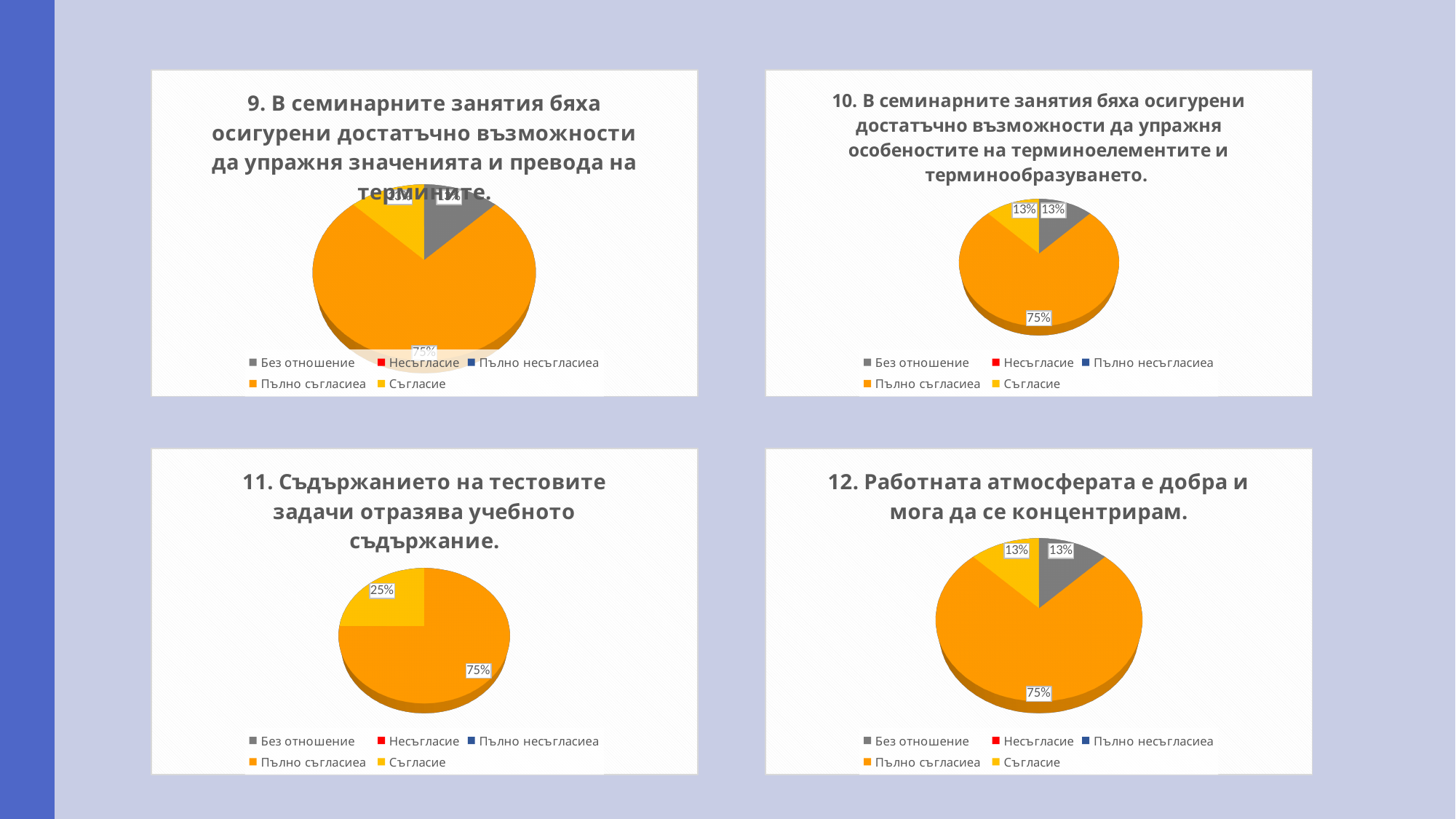
In the top-left chart (question 9), what share does "Пълно съгласиеа" have? 75% In the chart titled "12. Работната атмосферата е добра и мога да се концентрирам.", which category has the largest slice? Пълно съгласиеа In the chart titled "12. Работната атмосферата е добра и мога да се концентрирам.", what colour is the "Пълно съгласиеа" slice? Orange In the chart titled "10. В семинарните занятия бяха осигурени достатъчно възможности да упражня особеностите на терминоелементите и терминообразуването.", what share does "Без отношение" have? 13% In the chart titled "10. В семинарните занятия бяха осигурени достатъчно възможности да упражня особеностите на терминоелементите и терминообразуването.", what share does "Пълно съгласиеа" have? 75% What kind of chart is the chart titled "12. Работната атмосферата е добра и мога да се концентрирам."? Pie chart In the chart titled "10. В семинарните занятия бяха осигурени достатъчно възможности да упражня особеностите на терминоелементите и терминообразуването.", which is larger, the "Пълно съгласиеа" slice or the "Съгласие" slice? Пълно съгласиеа In the chart titled "11. Съдържанието на тестовите задачи отразява учебното съдържание.", what is the difference between the "Пълно съгласиеа" share and the "Съгласие" share? 50% How many entries does the legend list in the chart titled "11. Съдържанието на тестовите задачи отразява учебното съдържание."? 5